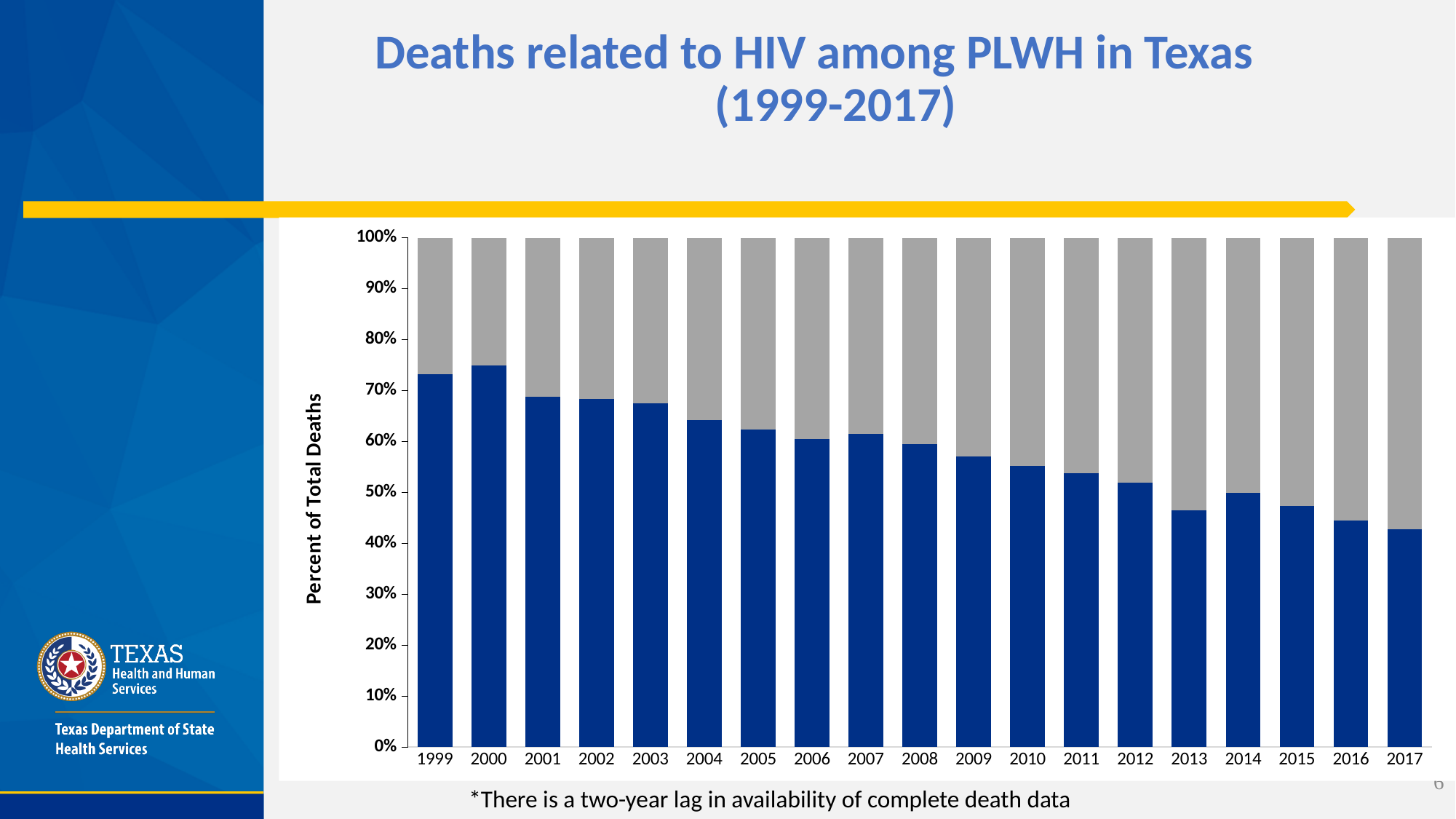
Does the blue segment generally rise or fall from 1999 to 2017? fall What is the label of the vertical axis? Percent of Total Deaths Is the blue segment for 2017 greater or less than 50%? less Is the blue segment for 2009 greater or less than 50%? greater Is the blue segment for 1999 greater or less than 70%? greater What kind of chart is shown on the slide? bar chart How many years are shown along the x axis of the chart? 19 Which is larger, the blue segment for 1999 or for 2017? 1999 What is the total height of each stacked bar? 100% Which year has the largest blue segment? 2000 What is the title of the chart on the slide? Deaths related to HIV among PLWH in Texas (1999-2017)